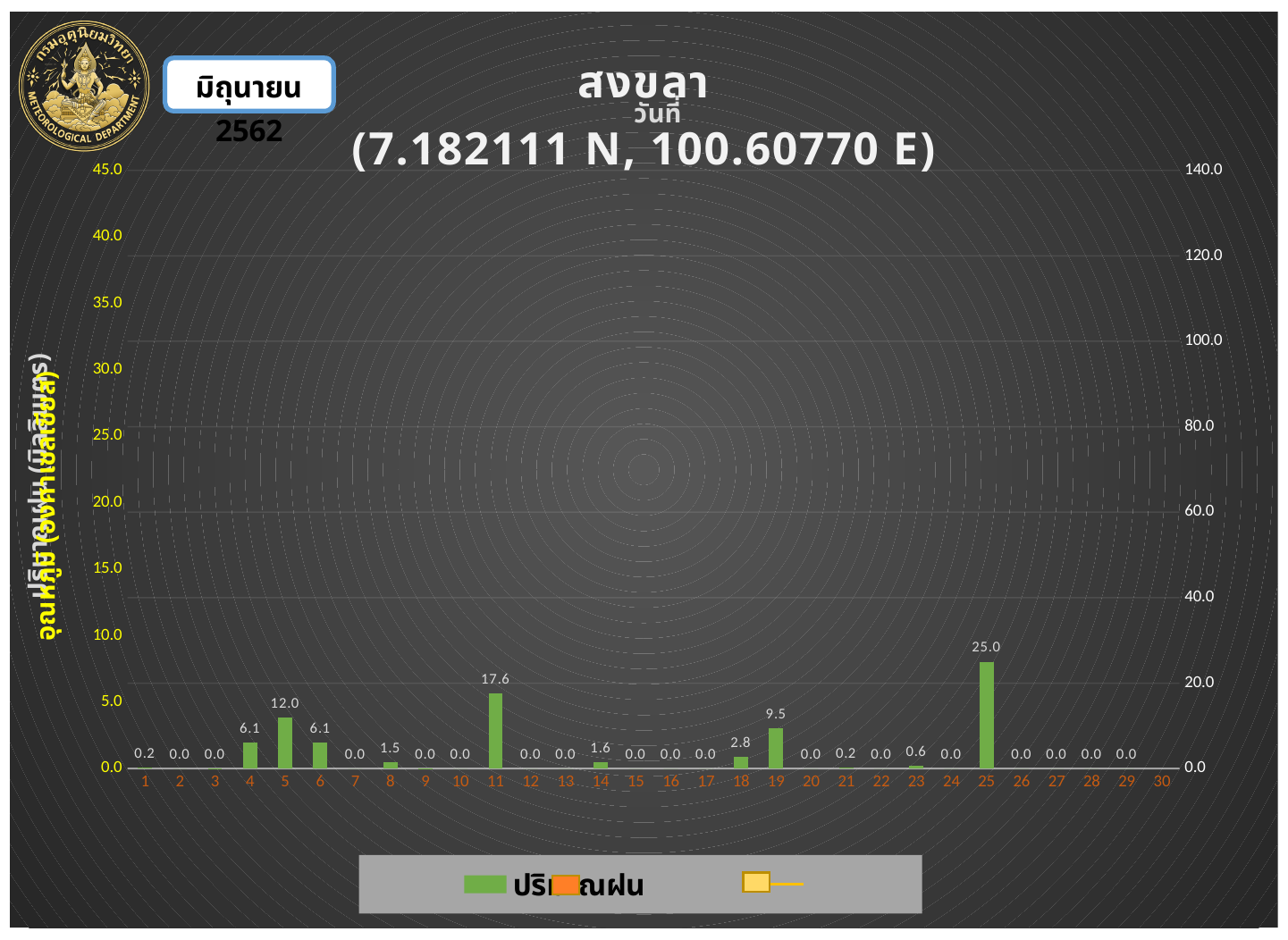
What is the value shown for day 5? 12.0 What is the value shown for day 19? 9.5 What is the difference between the values for day 11 and day 19? 8.1 What is the value shown for day 25? 25.0 Which is larger, the value for day 5 or the value for day 19? day 5 What is the difference between the values for day 25 and day 11? 7.4 What is the value shown for day 11? 17.6 How many days are shown on the x axis? 30 Is the value for day 25 greater or less than 20.0 on the right-hand axis? greater What is the station name shown in the chart title? สงขลา What kind of chart is this? bar chart Which day has the highest value? 25